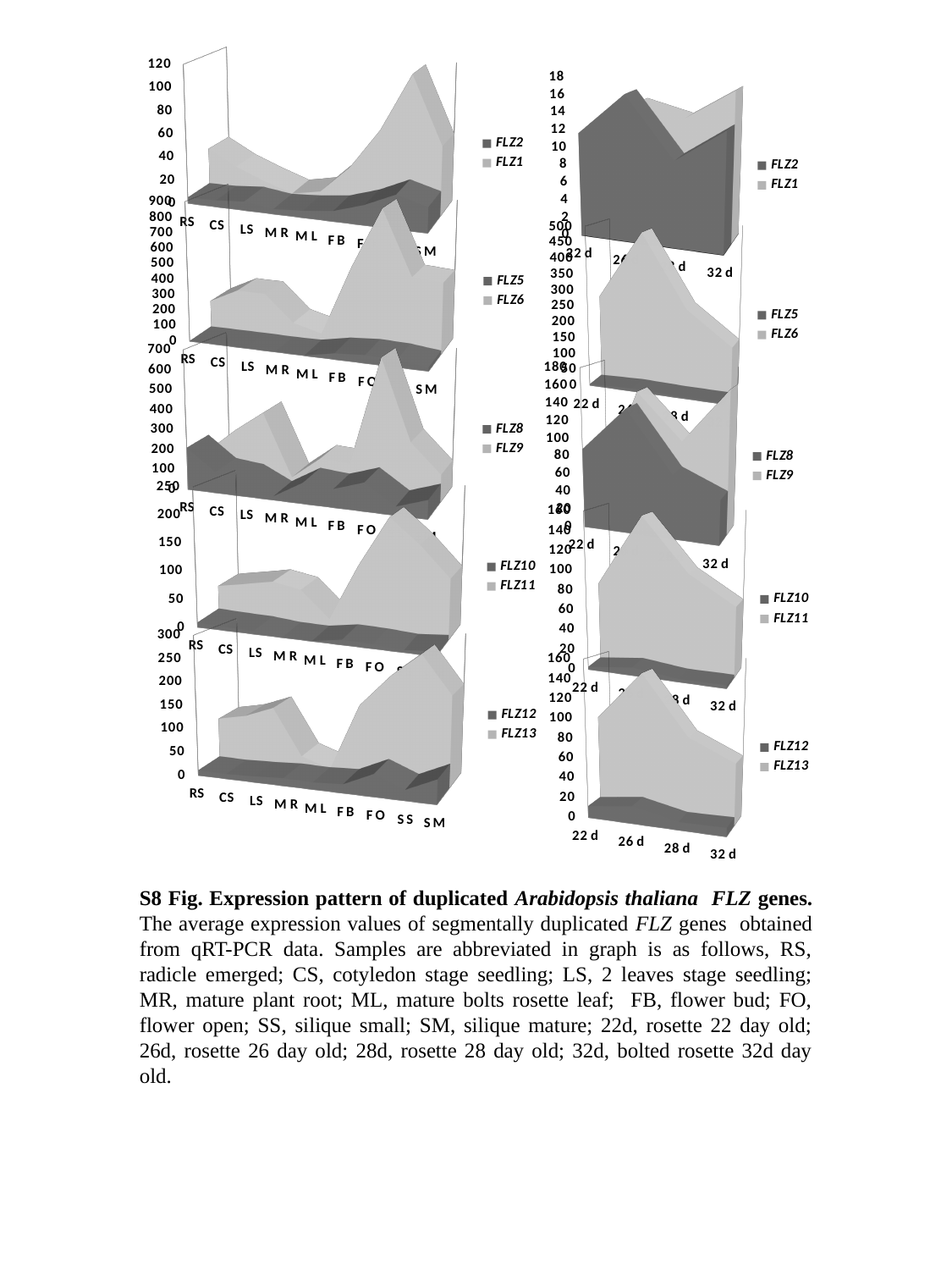
In the bottom-right chart (FLZ12/FLZ13), does the FLZ13 value rise or fall from 26 d to 32 d? fall What kind of chart is the top-left chart (FLZ2/FLZ1 across RS to SM)? 3D area chart In the fourth chart from the top on the right (FLZ10/FLZ11), is the value for FLZ11 at 26 d greater or less than 100? greater How many series does the legend list for the top-left chart (FLZ2/FLZ1)? 2 How many time-point categories are shown on the x axis of the bottom-right chart (FLZ12/FLZ13)? 4 What is the first category label on the x axis of the left-column charts? RS In the bottom-right chart (FLZ12/FLZ13), is the value for FLZ13 at 26 d greater or less than 100? greater In the bottom-right chart (FLZ12/FLZ13), is the value for FLZ12 at 22 d greater or less than 40? less How many sample categories are shown on the x axis of the bottom-left chart (FLZ12/FLZ13)? 9 Which two genes are listed in the legend of the middle-left chart (third chart down on the left)? FLZ8 and FLZ9